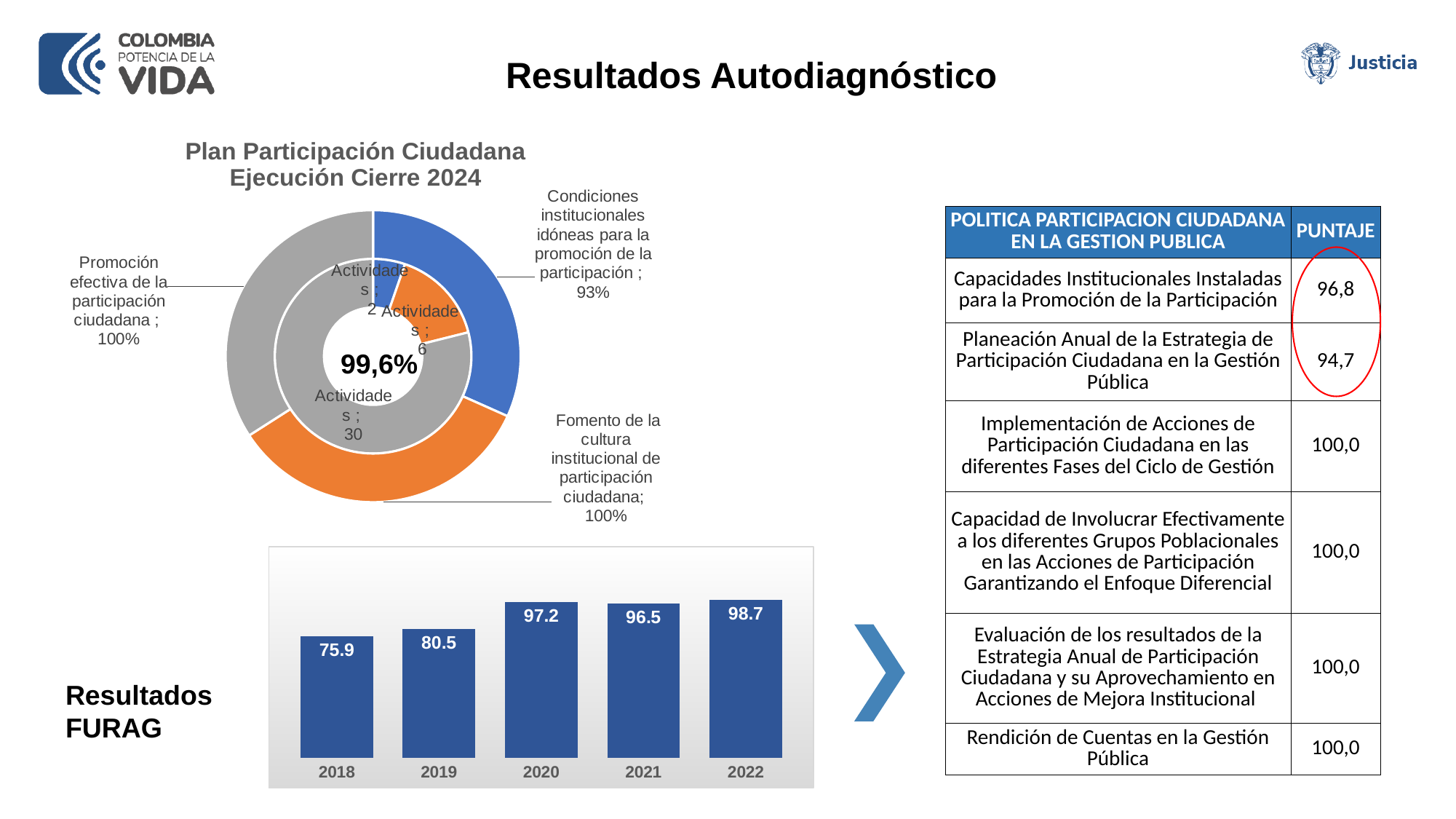
In the Resultados FURAG bar chart, what is the value for 2020? 97.2 How many bars are shown in the Resultados FURAG bar chart? 5 What kind of chart is the Plan Participación Ciudadana Ejecución Cierre 2024 chart? doughnut chart What percentage is displayed in the centre of the Plan Participación Ciudadana Ejecución Cierre 2024 chart? 99,6% In the Resultados FURAG bar chart, which year has the lowest value? 2018 In the Plan Participación Ciudadana Ejecución Cierre 2024 chart, what percentage is shown for 'Condiciones institucionales idóneas para la promoción de la participación'? 93% In the Resultados FURAG bar chart, what is the value for 2018? 75.9 In the Resultados FURAG bar chart, what is the difference between the values for 2019 and 2018? 4.6 In the Resultados FURAG bar chart, which year has the highest value? 2022 In the Resultados FURAG bar chart, which is larger, the value for 2020 or the value for 2021? 2020 In the Resultados FURAG bar chart, do the values generally rise or fall from 2018 to 2022? rise What kind of chart is the Resultados FURAG chart? bar chart